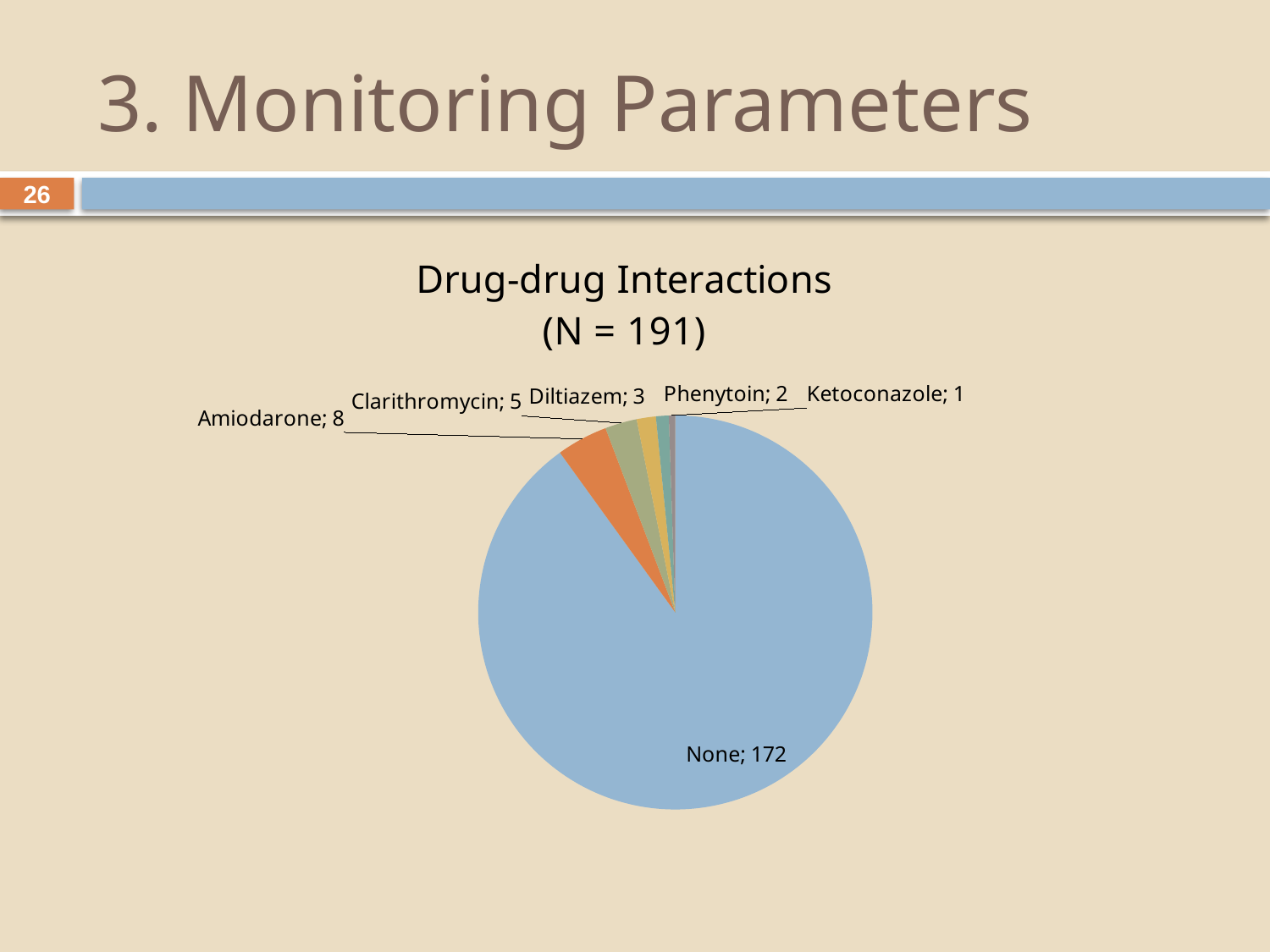
What type of chart is shown on the slide? Pie chart What is the value for Diltiazem? 3 What is the total of all slices in the pie chart? 191 Which category has the smallest slice? Ketoconazole Which category has the largest slice? None What is the value for Clarithromycin? 5 How many slices does the pie chart have? 6 What is the difference between the values for Amiodarone and Phenytoin? 6 What is the title of the chart? Drug-drug Interactions (N = 191) What is the value for None? 172 Which is larger, the value for Clarithromycin or the value for Diltiazem? Clarithromycin What is the value for Amiodarone? 8